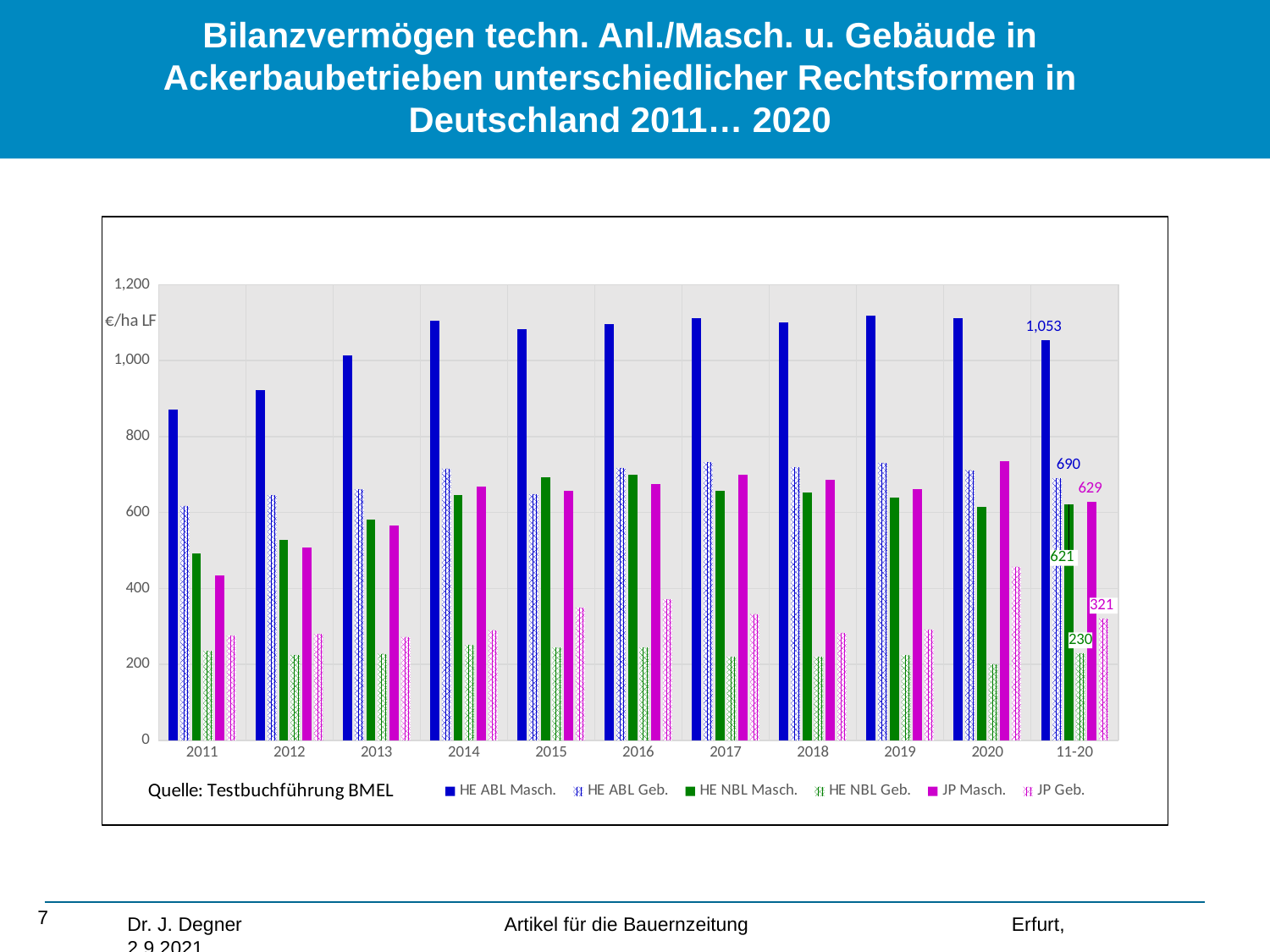
In the 11-20 group, which is larger: HE ABL Masch. or JP Masch.? HE ABL Masch. How many categories are shown on the x axis? 11 What is the value for JP Geb. in the 11-20 group? 321 Which series has the highest value in the 11-20 group? HE ABL Masch. Is the value for HE ABL Masch. in 2011 greater or less than 800? greater What kind of chart is shown on the slide? bar chart Is the value for HE NBL Geb. in 2011 greater or less than 400? less What is the difference between HE ABL Masch. and HE ABL Geb. in the 11-20 group? 363 How many series does the legend list? 6 Which series has the lowest value in the 11-20 group? HE NBL Geb. What is the value for HE NBL Geb. in the 11-20 group? 230 What is the value for HE ABL Masch. in the 11-20 group? 1,053